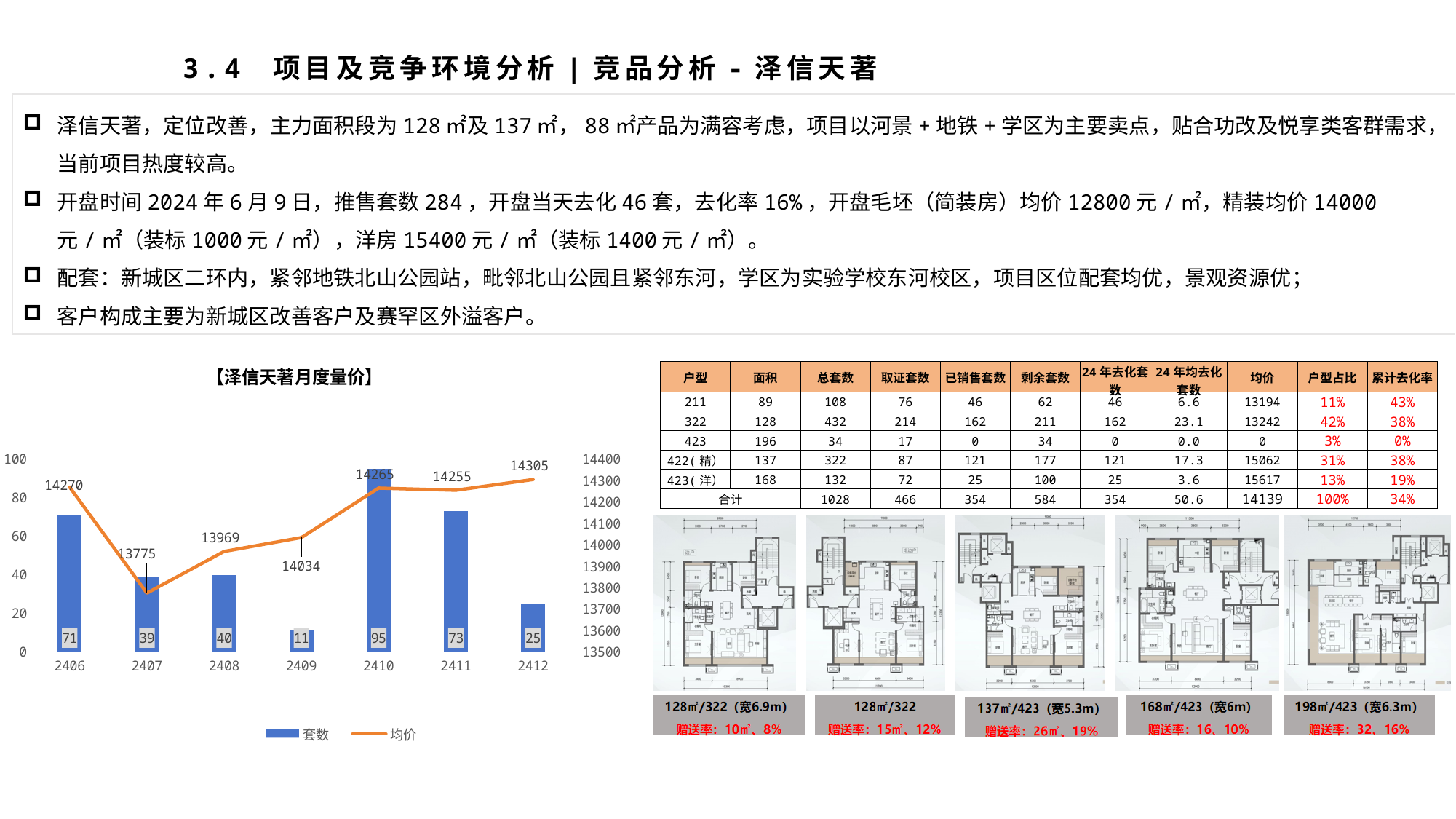
In the 【泽信天著月度量价】 chart, which month has the lowest 均价? 2407 In the 【泽信天著月度量价】 chart, what is the difference in 套数 between 2410 and 2409? 84 In the 【泽信天著月度量价】 chart, what is the 套数 value for 2410? 95 In the 【泽信天著月度量价】 chart, what is the 均价 value for 2407? 13775 What kind of chart is the 【泽信天著月度量价】 chart? Combined bar and line chart How many months are shown on the x axis of the 【泽信天著月度量价】 chart? 7 In the 【泽信天著月度量价】 chart, what is the difference in 均价 between 2412 and 2406? 35 In the 【泽信天著月度量价】 chart, what is the 套数 value for 2412? 25 In the 【泽信天著月度量价】 chart, which month has the highest 套数? 2410 How many series does the legend of the 【泽信天著月度量价】 chart list? 2 In the 【泽信天著月度量价】 chart, which is larger, the 套数 for 2406 or for 2411? 2411 In the 【泽信天著月度量价】 chart, which month has the lowest 套数? 2409